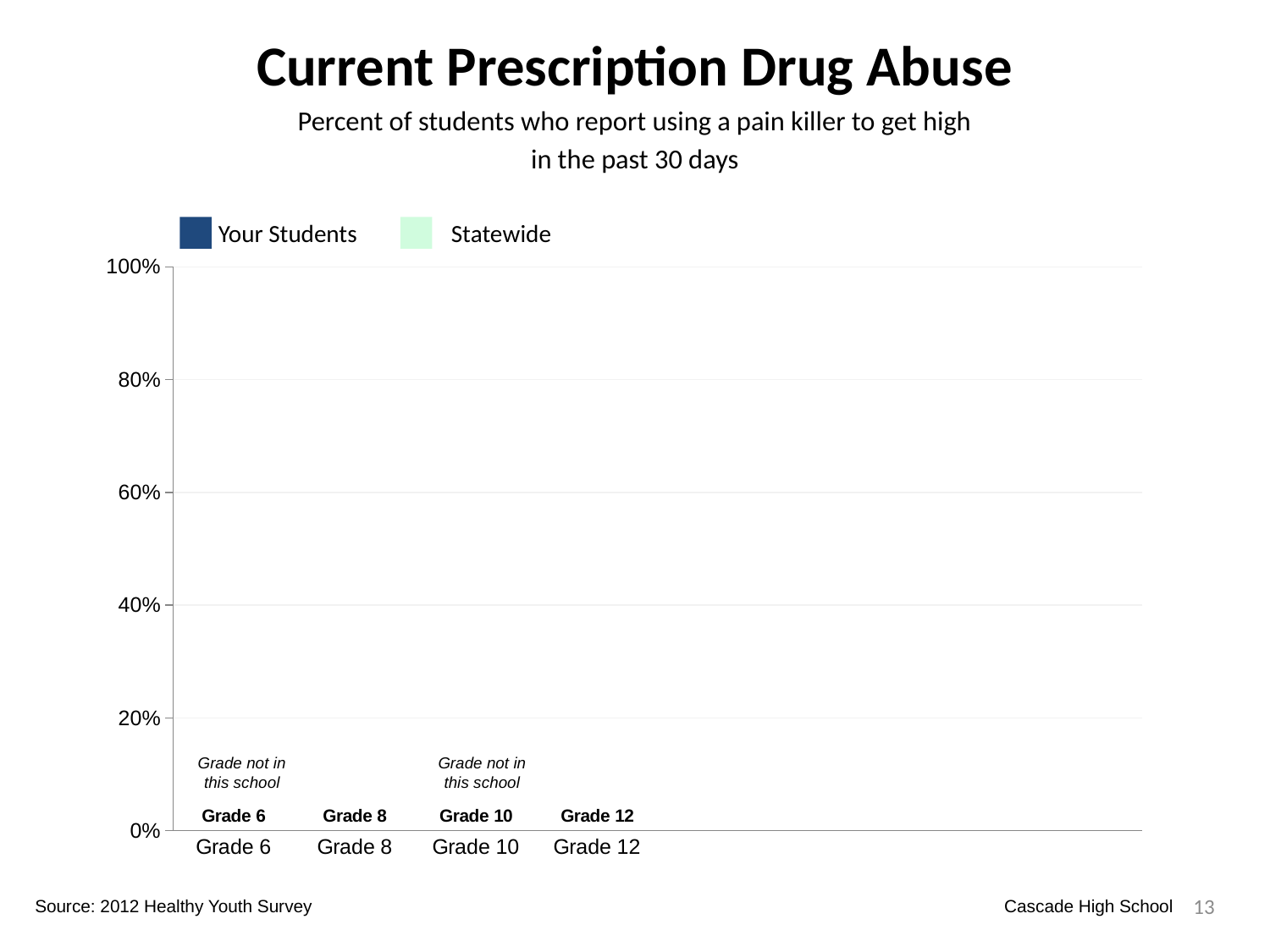
How many series does the chart's legend list? 2 What is the lowest value shown on the chart's y axis? 0% What is the highest value shown on the chart's y axis? 100% What is the title of the chart? Current Prescription Drug Abuse What is the interval between tick marks on the chart's y axis? 20% Which grades are marked as 'Grade not in this school' on the chart? Grade 6 and Grade 10 What are the two series named in the chart's legend? Your Students and Statewide How many grade categories are shown on the x axis of the chart? 4